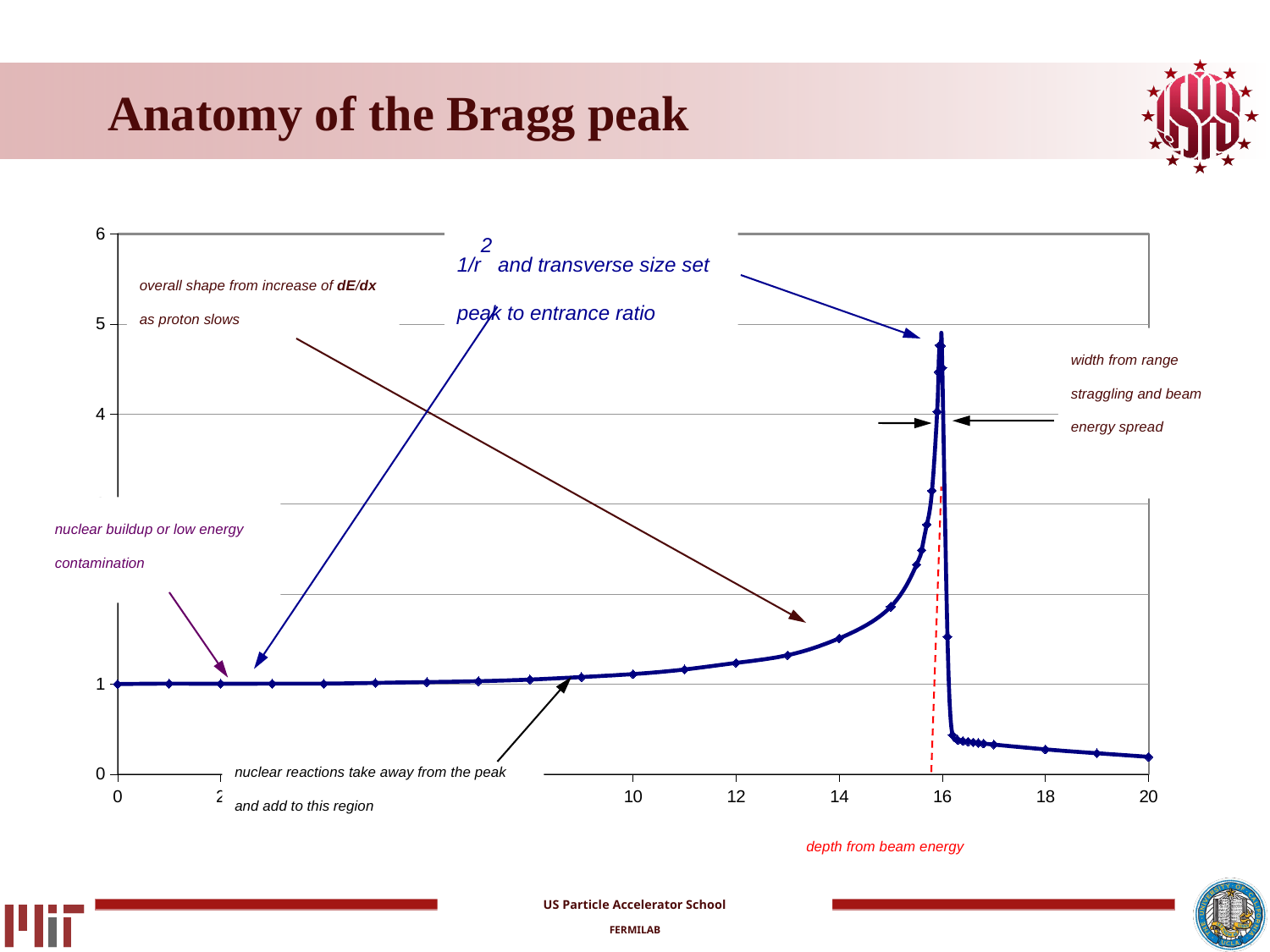
Does the curve rise or fall as depth increases from 17 to 20? fall What is the title of the slide containing the chart? Anatomy of the Bragg peak Which is larger, the value of the curve at depth 10 or at depth 18? depth 10 What kind of chart is shown on the slide? line chart Is the maximum value of the curve at the peak greater or less than 4? greater Is the value of the curve at depth 20 greater or less than 1? less Is the value of the curve at depth 0 greater or less than 4? less Does the curve rise or fall as depth increases from 0 to 15? rise Is the peak of the curve located closer to the x-axis value 16 or 18? 16 According to the annotation on the chart, what determines the width of the peak? range straggling and beam energy spread